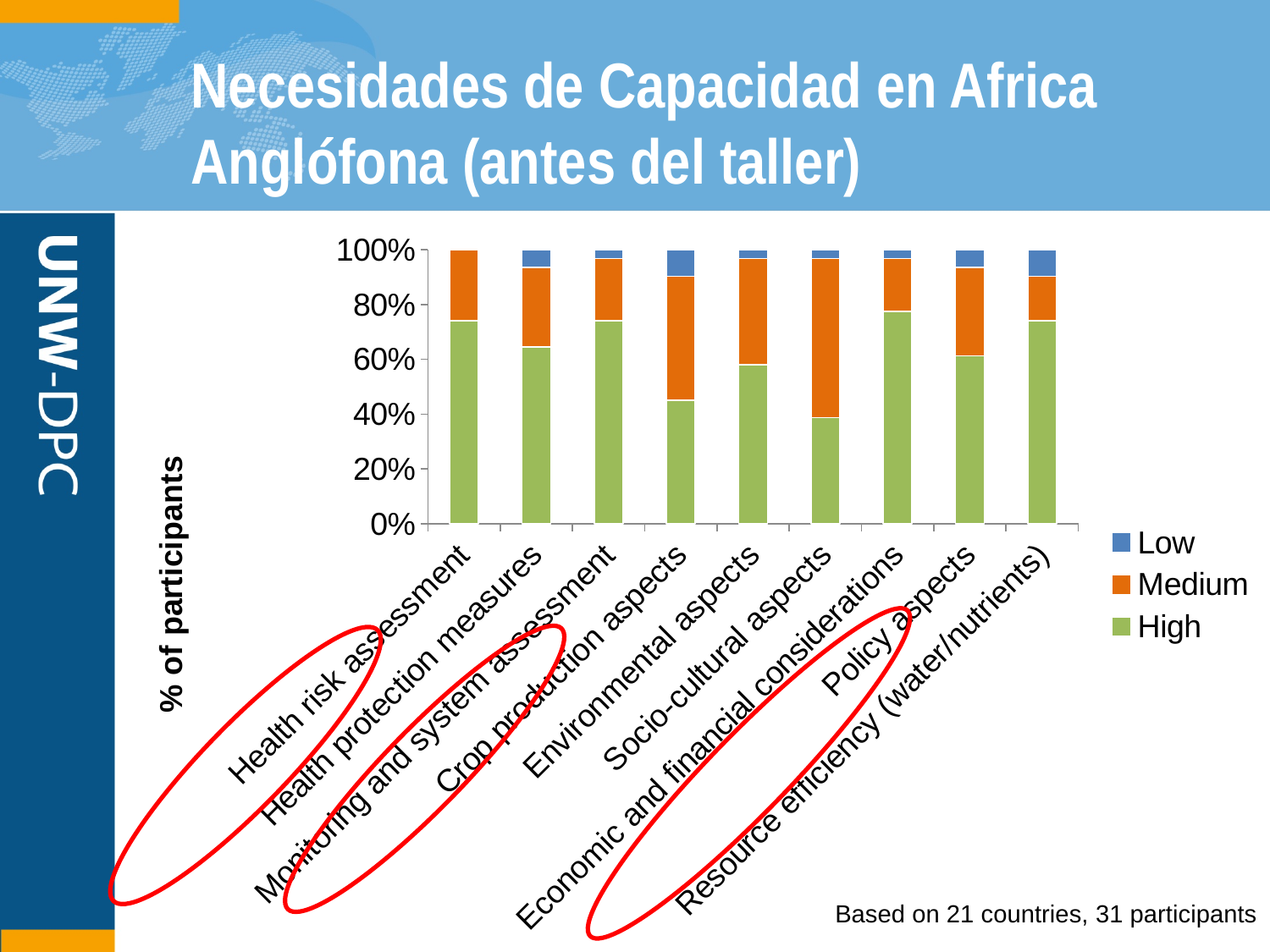
How many categories are plotted along the x axis? 9 How many series does the legend list? 3 Which has the larger Medium share: Socio-cultural aspects or Health risk assessment? Socio-cultural aspects What are the three series named in the legend? Low, Medium, High Is the High value for Crop production aspects greater or less than 60%? less Is the High value for Health risk assessment greater or less than 60%? greater Is the High value for Economic and financial considerations greater or less than 60%? greater What is the label of the vertical axis? % of participants Which has the larger High share: Health risk assessment or Socio-cultural aspects? Health risk assessment Which category has the smallest High share? Socio-cultural aspects What kind of chart is shown on the slide? Stacked bar chart